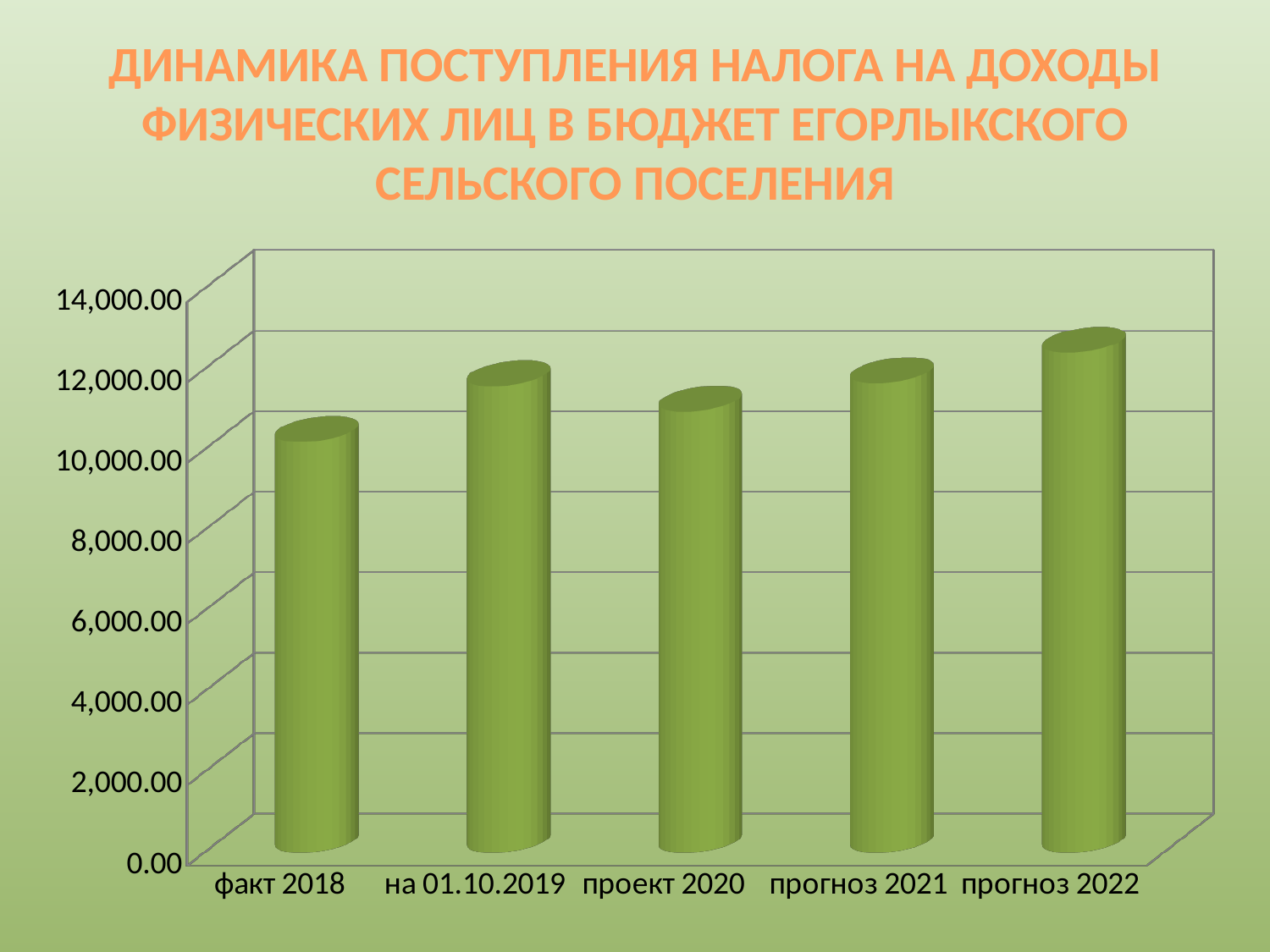
Is the value for факт 2018 greater or less than 12,000.00? less What kind of chart is shown on the slide? bar chart Is the value for факт 2018 greater or less than 8,000.00? greater What colour are the bars in the chart? green What is the label of the first category on the x axis? факт 2018 Which is larger, the value for на 01.10.2019 or the value for проект 2020? на 01.10.2019 Is the value for прогноз 2022 greater or less than 10,000.00? greater Which category has the highest value in the chart? прогноз 2022 Which category has the lowest value in the chart? факт 2018 Which is larger, the value for прогноз 2022 or the value for факт 2018? прогноз 2022 How many categories are shown on the x axis of the chart? 5